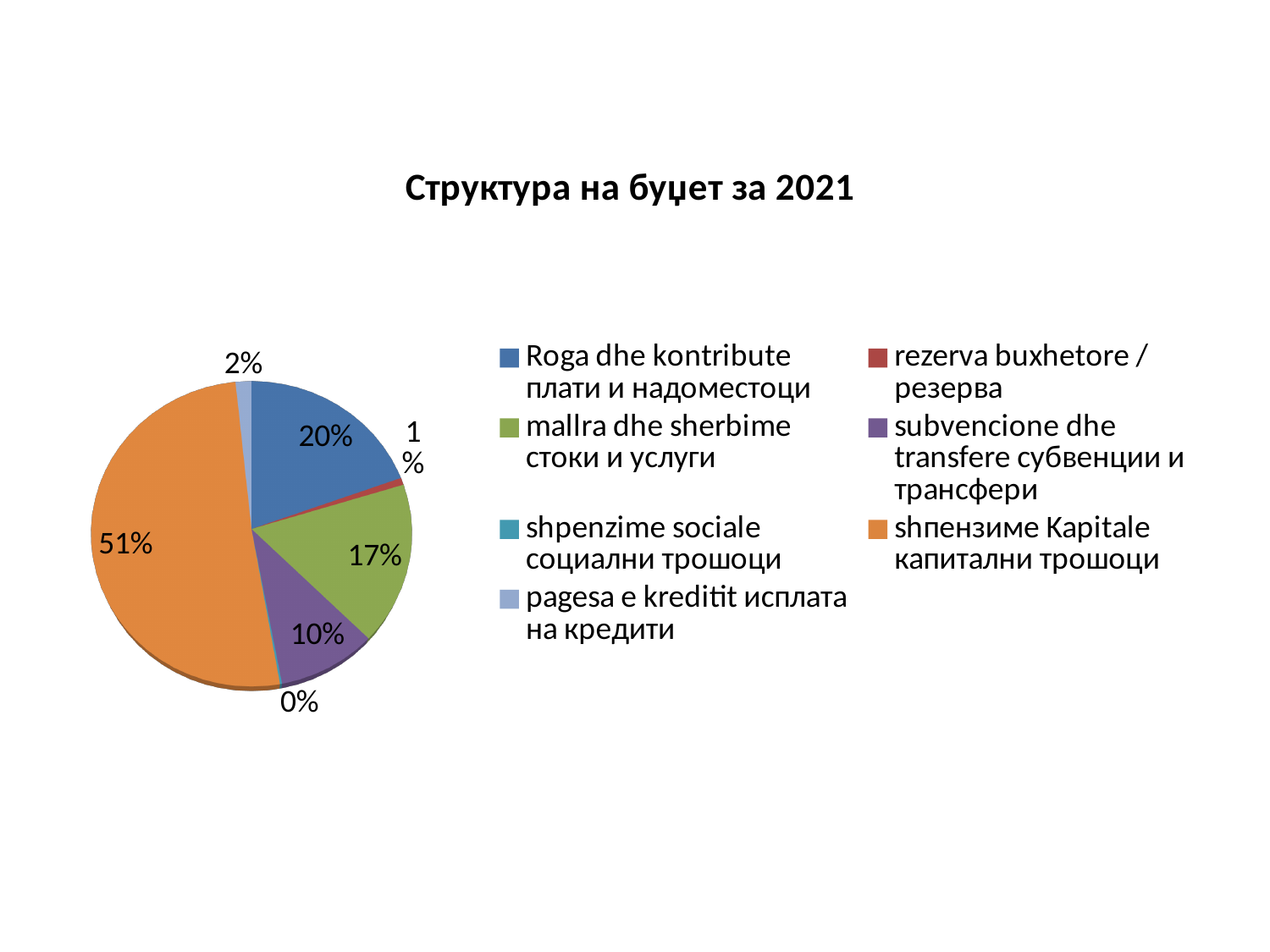
What is the difference between the shares of 'Roga dhe kontribute плати и надоместоци' and 'mallra dhe sherbime стоки и услуги'? 3% What is the title of the chart? Структура на буџет за 2021 What type of chart is shown on the slide? Pie chart How many categories does the legend list? 7 Which is larger, the share of 'subvencione dhe transfere субвенции и трансфери' or the share of 'mallra dhe sherbime стоки и услуги'? mallra dhe sherbime стоки и услуги What share of the pie does 'shпензиме Kapitale капитални трошоци' take? 51% Which category has the largest share of the pie? shпензиме Kapitale капитални трошоци What share of the pie does 'mallra dhe sherbime стоки и услуги' take? 17% What share of the pie does 'Roga dhe kontribute плати и надоместоци' take? 20% Which category has the smallest share of the pie? shpenzime sociale социални трошоци